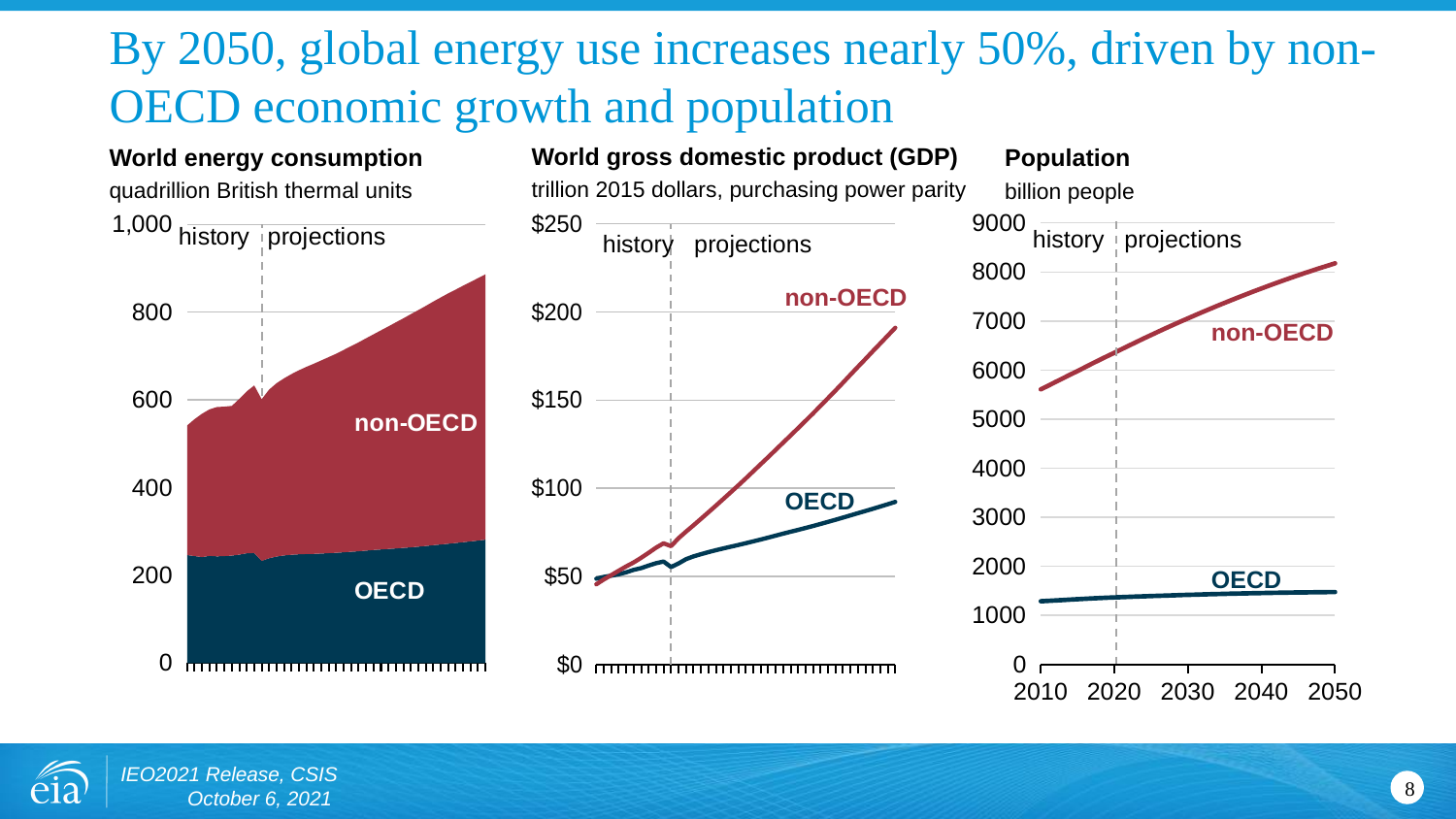
In the World gross domestic product (GDP) chart, is the non-OECD value at the end of the projections greater or less than $150? greater What kind of chart is the Population chart? line chart In the Population chart, is the OECD value in 2050 greater or less than 2000? less In the World energy consumption chart, is the OECD value at the end of the projections greater or less than 400? less What unit is used on the World energy consumption chart? quadrillion British thermal units In the Population chart, which series is higher in 2010, non-OECD or OECD? non-OECD In the World energy consumption chart, which series is larger at the end of the projection period, non-OECD or OECD? non-OECD How many series are shown in the World gross domestic product (GDP) chart? 2 What kind of chart is the World energy consumption chart? stacked area chart In the World gross domestic product (GDP) chart, does the non-OECD series rise or fall over time? rise